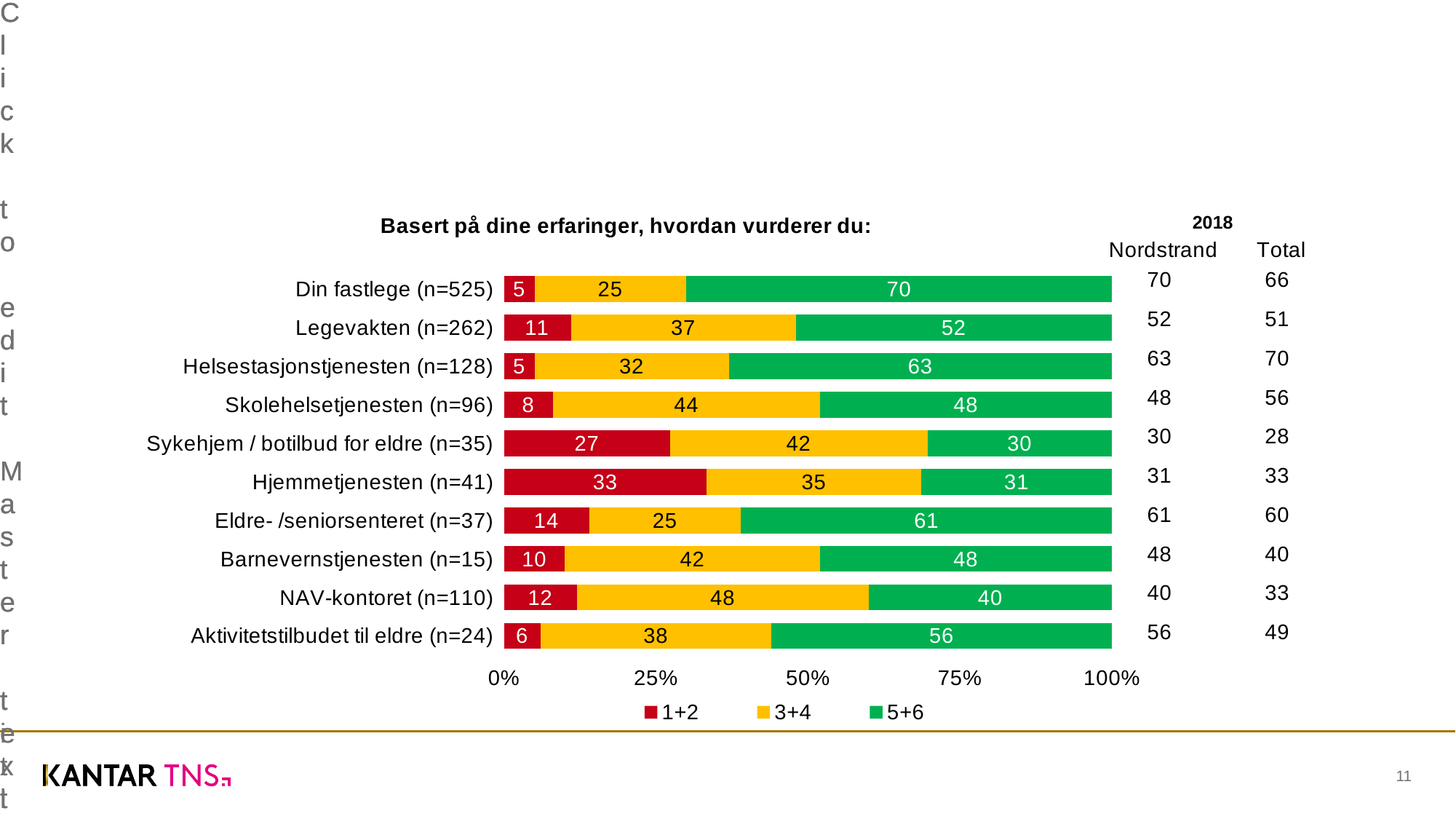
What is the total of the stacked bar for Eldre- /seniorsenteret (n=37)? 100 Which category has the lowest 5+6 value? Sykehjem / botilbud for eldre (n=35) How many categories are plotted in the chart? 10 Which category has the highest 5+6 value? Din fastlege (n=525) Which category has the highest 1+2 value? Hjemmetjenesten (n=41) What kind of chart is shown on the slide? Stacked bar chart Which is larger: the 3+4 value for Skolehelsetjenesten (n=96) or the 3+4 value for Aktivitetstilbudet til eldre (n=24)? Skolehelsetjenesten (n=96) What is the difference between the 5+6 values for Helsestasjonstjenesten (n=128) and Legevakten (n=262)? 11 How many series does the legend list? 3 What is the 1+2 value for Hjemmetjenesten (n=41)? 33 What is the 3+4 value for NAV-kontoret (n=110)? 48 What is the 5+6 value for Din fastlege (n=525)? 70